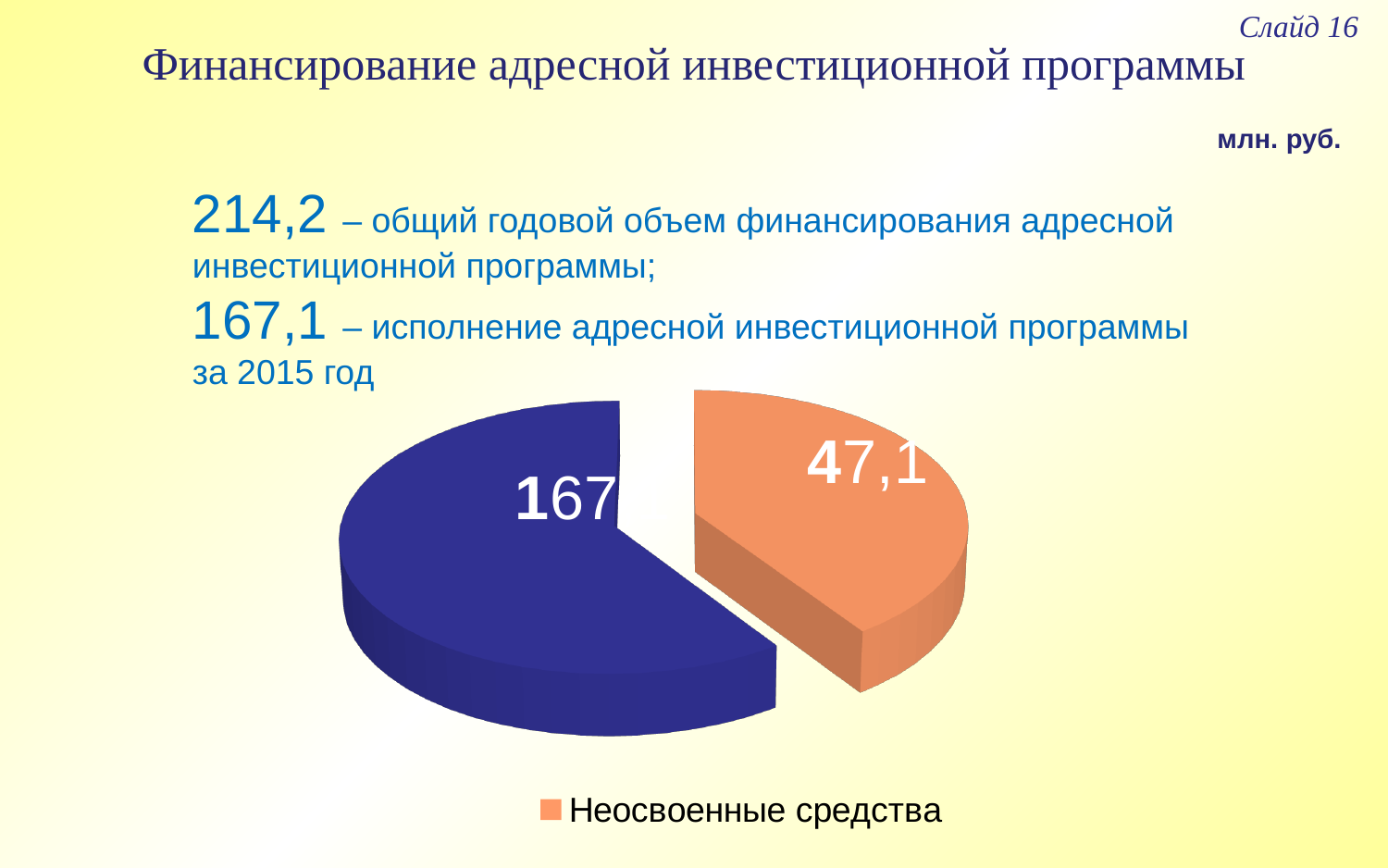
What is the name of the entry shown in the chart legend? Неосвоенные средства What is the value of the Неосвоенные средства slice in the pie chart? 47,1 How many entries does the chart legend list? 1 How many slices does the pie chart have? 2 Which slice of the pie chart is larger, the blue slice or the orange Неосвоенные средства slice? the blue slice What colour is the Неосвоенные средства slice in the pie chart? orange What kind of chart is shown on the slide? pie chart Which slice of the pie chart is the largest? the blue slice Which slice of the pie chart is the smallest? Неосвоенные средства